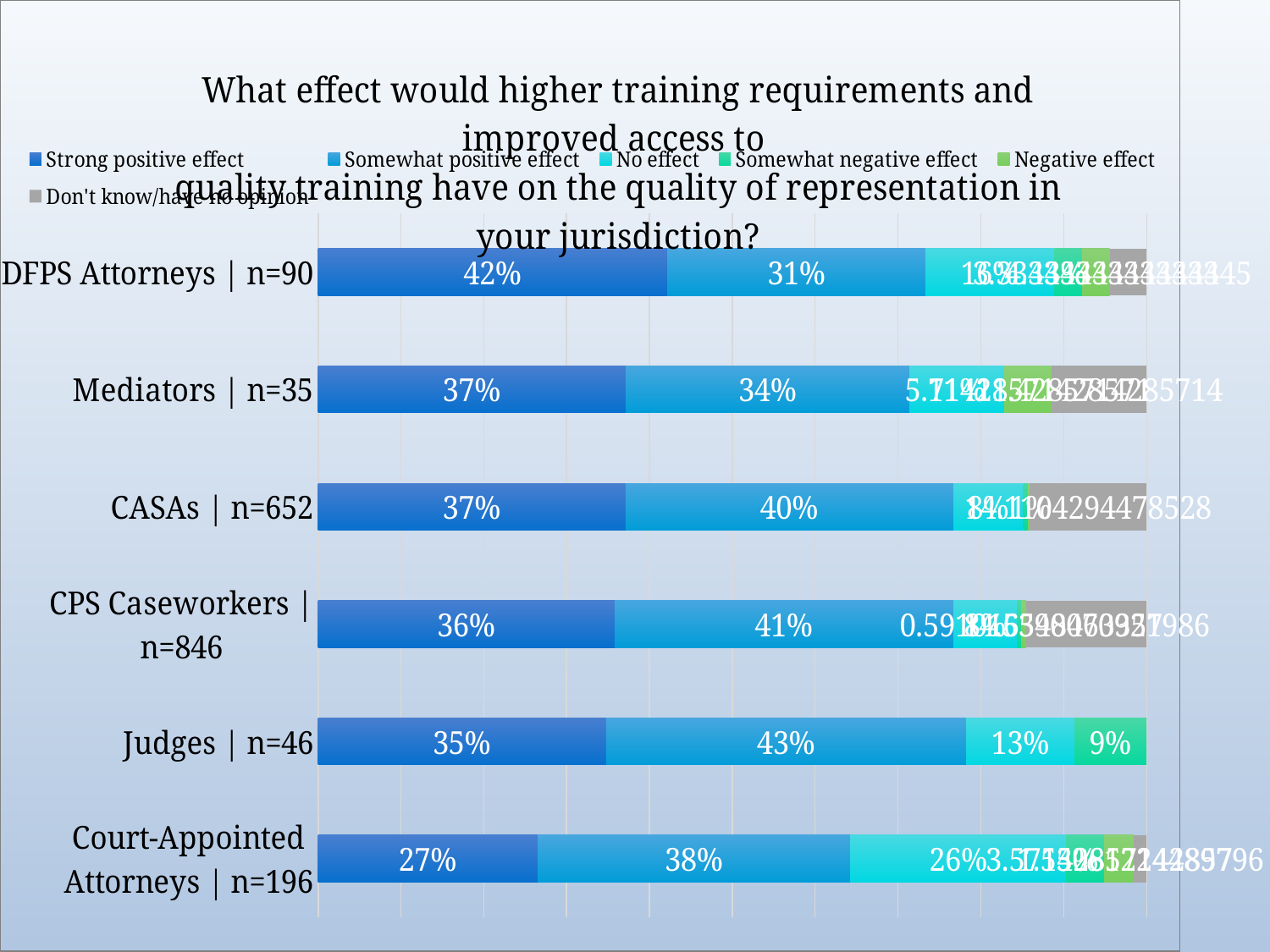
What is the 'No effect' value for Court-Appointed Attorneys | n=196? 26% What is the difference between the 'Somewhat positive effect' values for Judges | n=46 and DFPS Attorneys | n=90? 12% How many series does the legend list? 6 Which group has the lowest 'Strong positive effect' value? Court-Appointed Attorneys | n=196 How many respondent groups (categories) are plotted on the chart? 6 What kind of chart is shown on the slide? Stacked bar chart What is the 'Somewhat negative effect' value for Judges | n=46? 9% Which is larger: the 'Somewhat positive effect' value for CASAs | n=652 or for Mediators | n=35? CASAs | n=652 Which group has the highest 'Strong positive effect' value? DFPS Attorneys | n=90 What is the 'Somewhat positive effect' value for Judges | n=46? 43% Which legend entry is shown in grey? Don't know/have no opinion What is the 'Strong positive effect' value for DFPS Attorneys | n=90? 42%